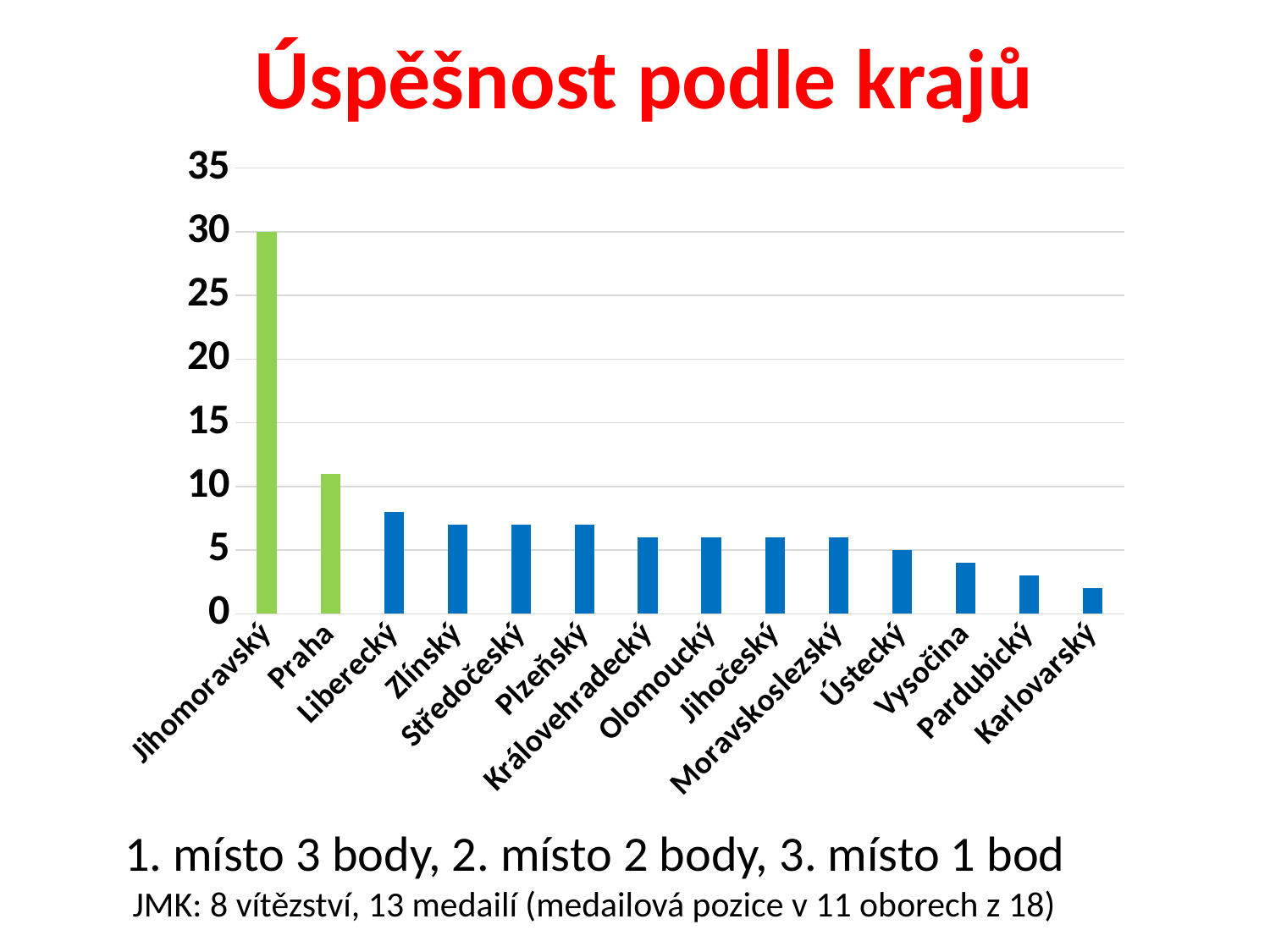
How many regions (categories) are shown on the x axis? 14 Which region has the highest value? Jihomoravský Is the value for Liberecký greater or less than 10? less Is the value for Karlovarský greater or less than 5? less Which is larger, the value for Praha or the value for Liberecký? Praha What is the title of the chart? Úspěšnost podle krajů What is the value for Ústecký? 5 What is the value for Jihomoravský? 30 What kind of chart is shown on the slide? bar chart Which region has the lowest value? Karlovarský Is the value for Praha greater or less than 10? greater Do the values generally rise or fall from left to right along the x axis? fall